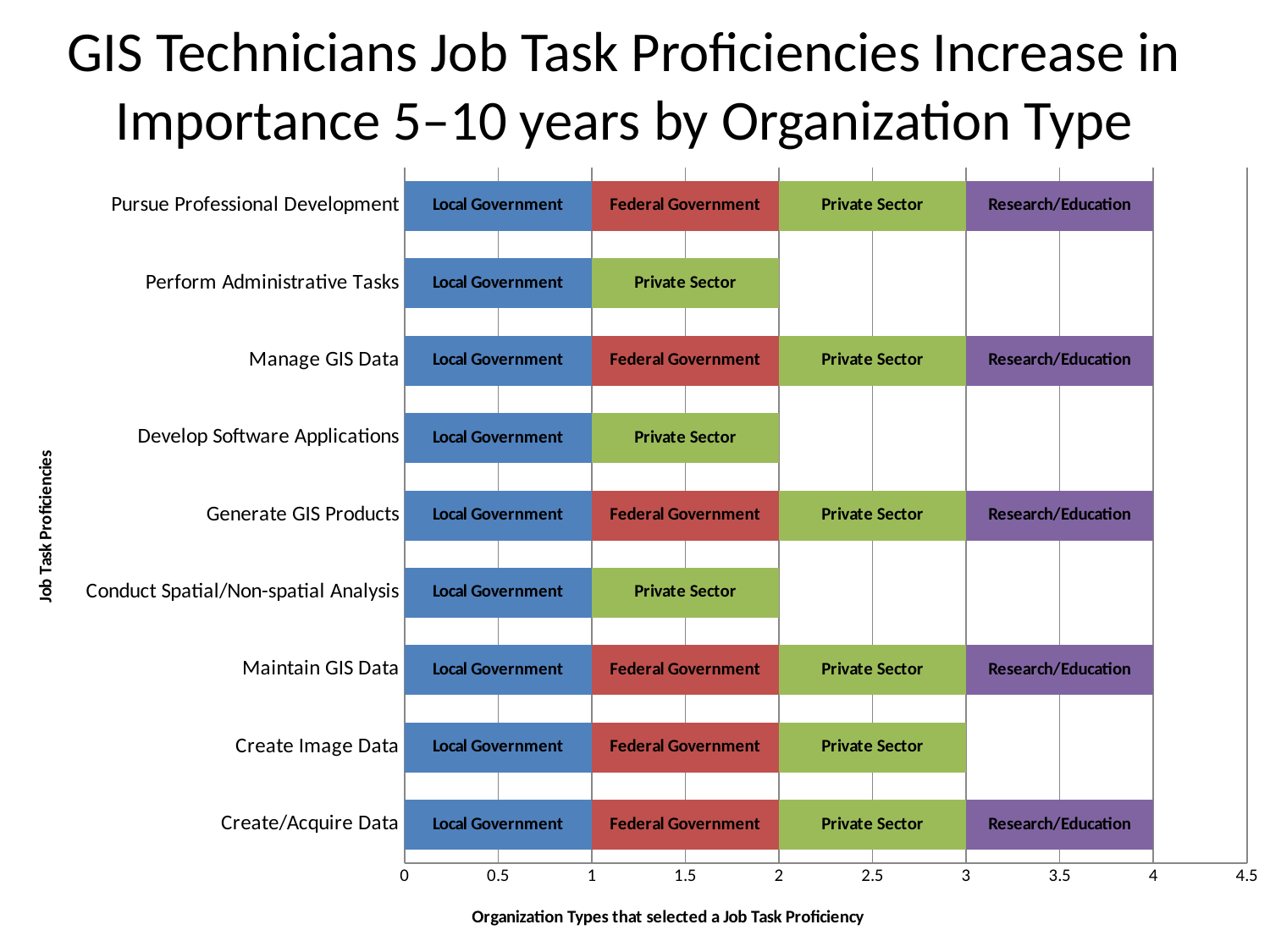
What is the title of the x axis? Organization Types that selected a Job Task Proficiency Which bar is longer, Manage GIS Data or Develop Software Applications? Manage GIS Data What is the total length of the bar for Perform Administrative Tasks? 2 How many organization types selected Conduct Spatial/Non-spatial Analysis? 2 What is the difference between the total for Create/Acquire Data and the total for Create Image Data? 1 What is the total length of the bar for Create Image Data? 3 What kind of chart is shown on the slide? bar chart Which bar is longer, Create Image Data or Create/Acquire Data? Create/Acquire Data How many job task proficiencies are listed on the y axis? 9 What is the total length of the bar for Pursue Professional Development? 4 Is the total for Maintain GIS Data greater or less than 3.5? greater Which organization type is missing from the Create Image Data bar? Research/Education